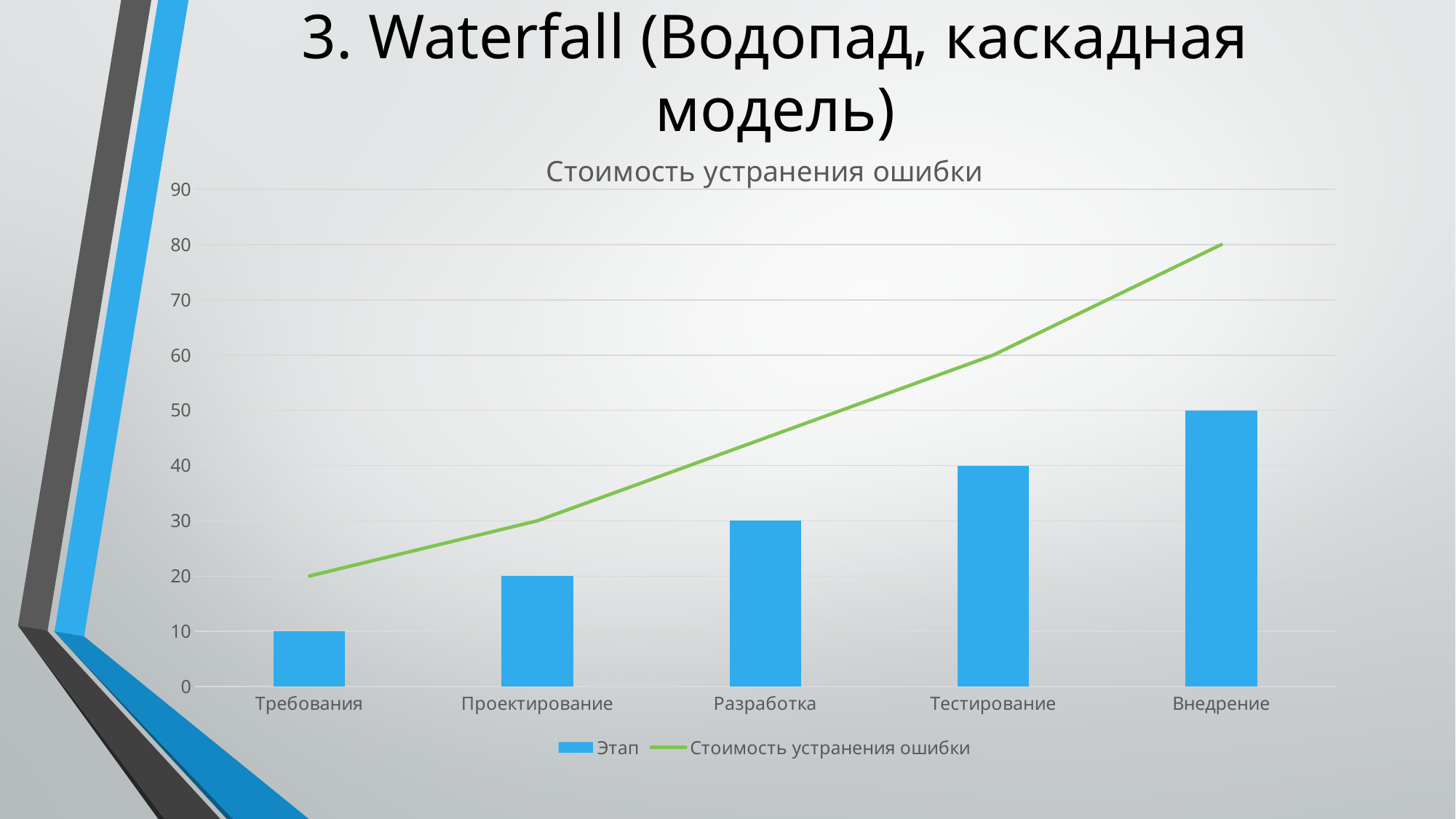
How many categories are shown on the x axis? 5 What type of chart is shown on the slide? Combined bar and line chart Does the Стоимость устранения ошибки line rise or fall from Требования to Внедрение? Rises What is the difference between the Этап bars for Тестирование and Проектирование? 20 What is the title of the chart? Стоимость устранения ошибки Which is larger for Проектирование: the Этап bar or the Стоимость устранения ошибки line? Стоимость устранения ошибки line Which category has the lowest Этап bar? Требования What is the value of the Этап bar for Разработка? 30 What is the value of the Этап bar for Внедрение? 50 Which category has the highest Этап bar? Внедрение Is the value of the Стоимость устранения ошибки line for Тестирование greater or less than 50? greater How many series does the legend list? 2